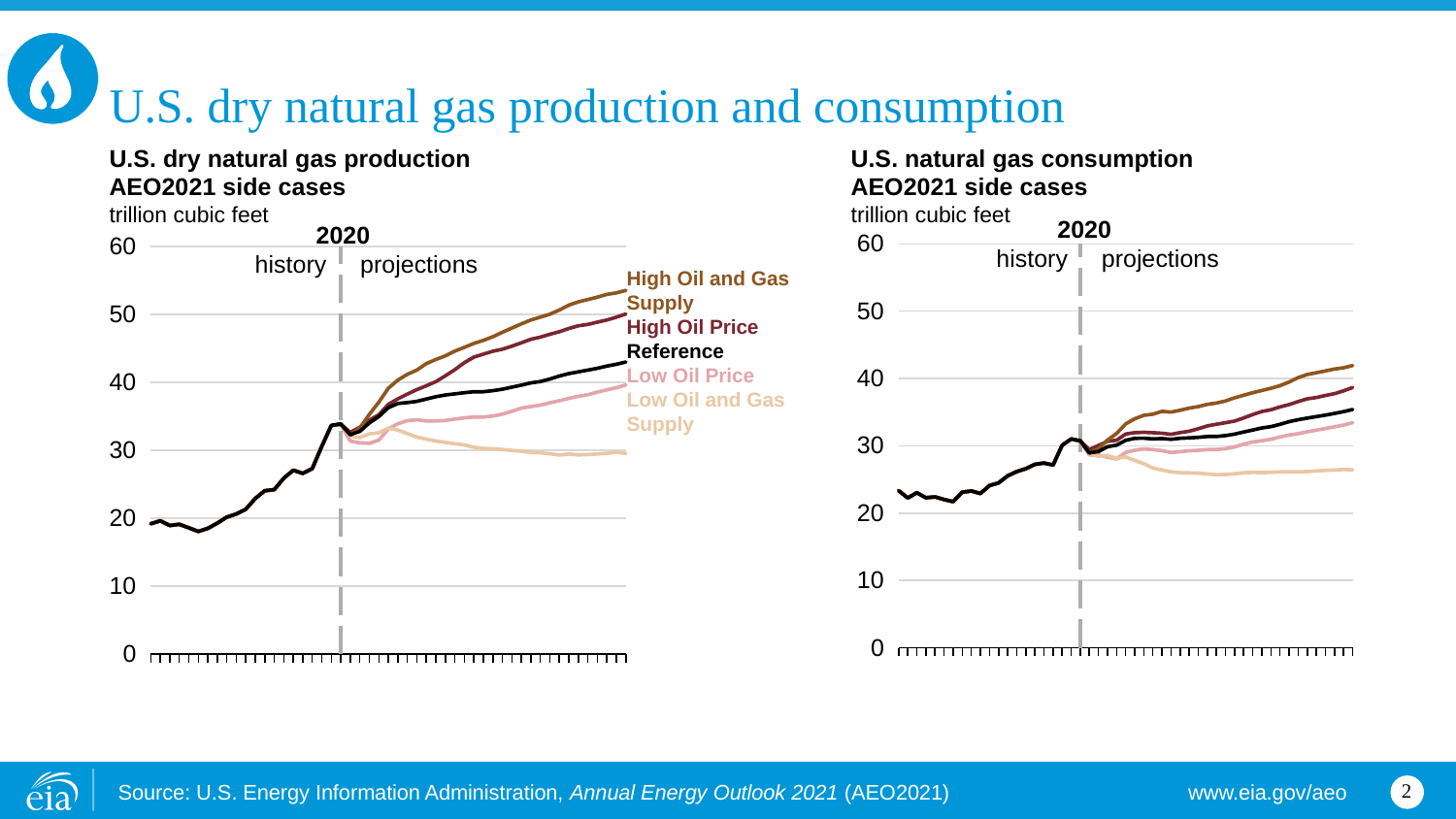
In the U.S. dry natural gas production chart, does the Low Oil and Gas Supply series rise or fall over the projection period? fall In the U.S. dry natural gas production chart, which is larger at the end of the projections: High Oil Price or Reference? High Oil Price In the U.S. dry natural gas production chart, which series is lowest at the end of the projection period? Low Oil and Gas Supply In the U.S. natural gas consumption chart, is the final value of the lowest series greater or less than 30? less What kind of chart is the U.S. dry natural gas production chart on the left? line chart What year does the dashed vertical line separating history from projections mark in both charts? 2020 In the U.S. dry natural gas production chart, is the final value of the High Oil and Gas Supply series greater or less than 50? greater In the U.S. natural gas consumption chart, is the final value of the highest series greater or less than 40? greater What unit is used on the y axis of both charts? trillion cubic feet In the U.S. dry natural gas production chart, which series is highest at the end of the projection period? High Oil and Gas Supply How many series does the legend of the U.S. dry natural gas production chart list? 5